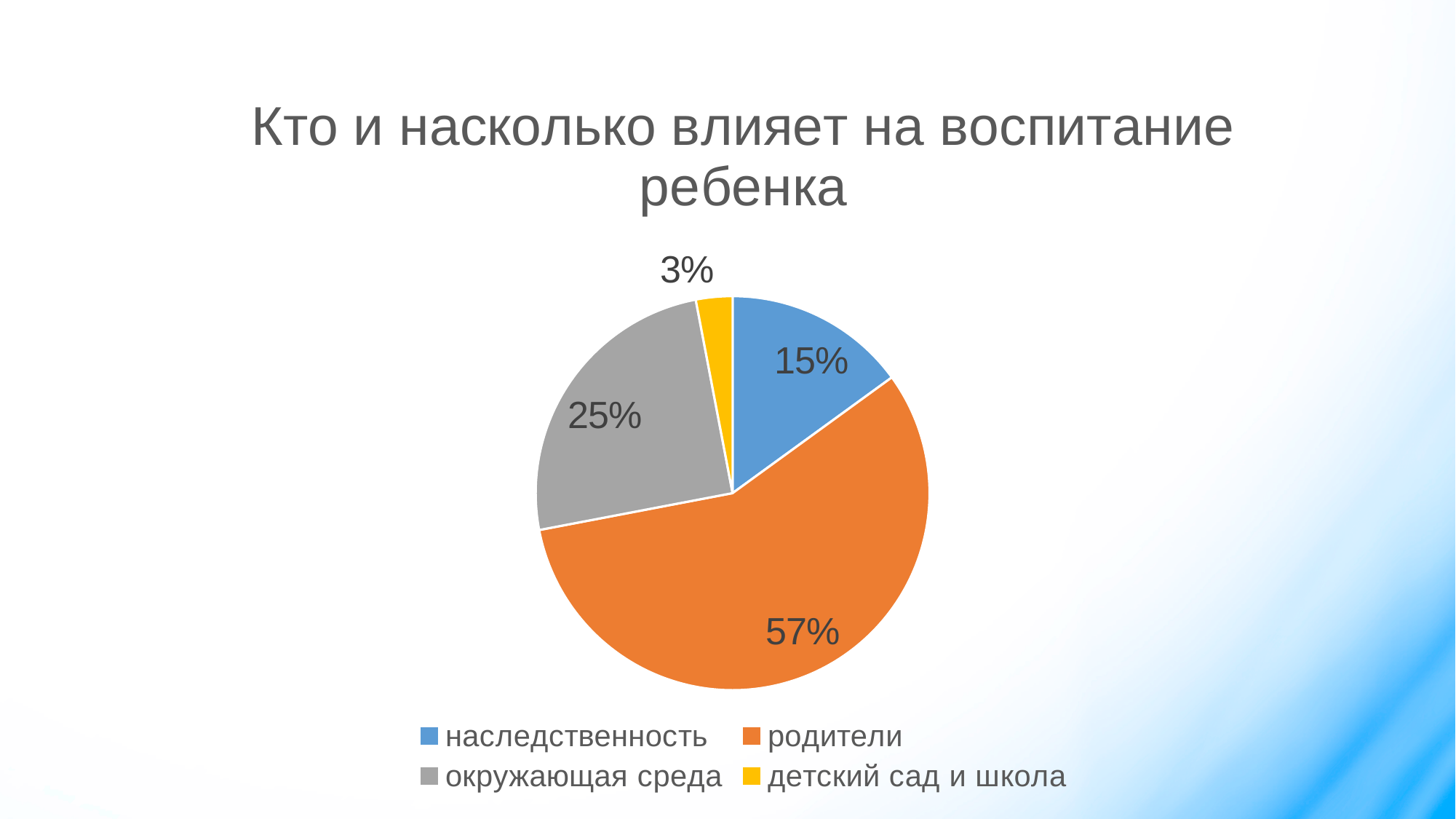
What share of the pie does родители have? 57% Which category has the smallest slice of the pie? детский сад и школа What is the difference between the shares of родители and окружающая среда? 32% How many categories does the pie chart have? 4 What share of the pie does окружающая среда have? 25% What is the title of the chart? Кто и насколько влияет на воспитание ребенка Which is larger, the share for наследственность or the share for окружающая среда? окружающая среда Which category has the largest slice of the pie? родители What share of the pie does детский сад и школа have? 3% Which colour represents родители in the pie chart? orange What kind of chart is shown on the slide? pie chart